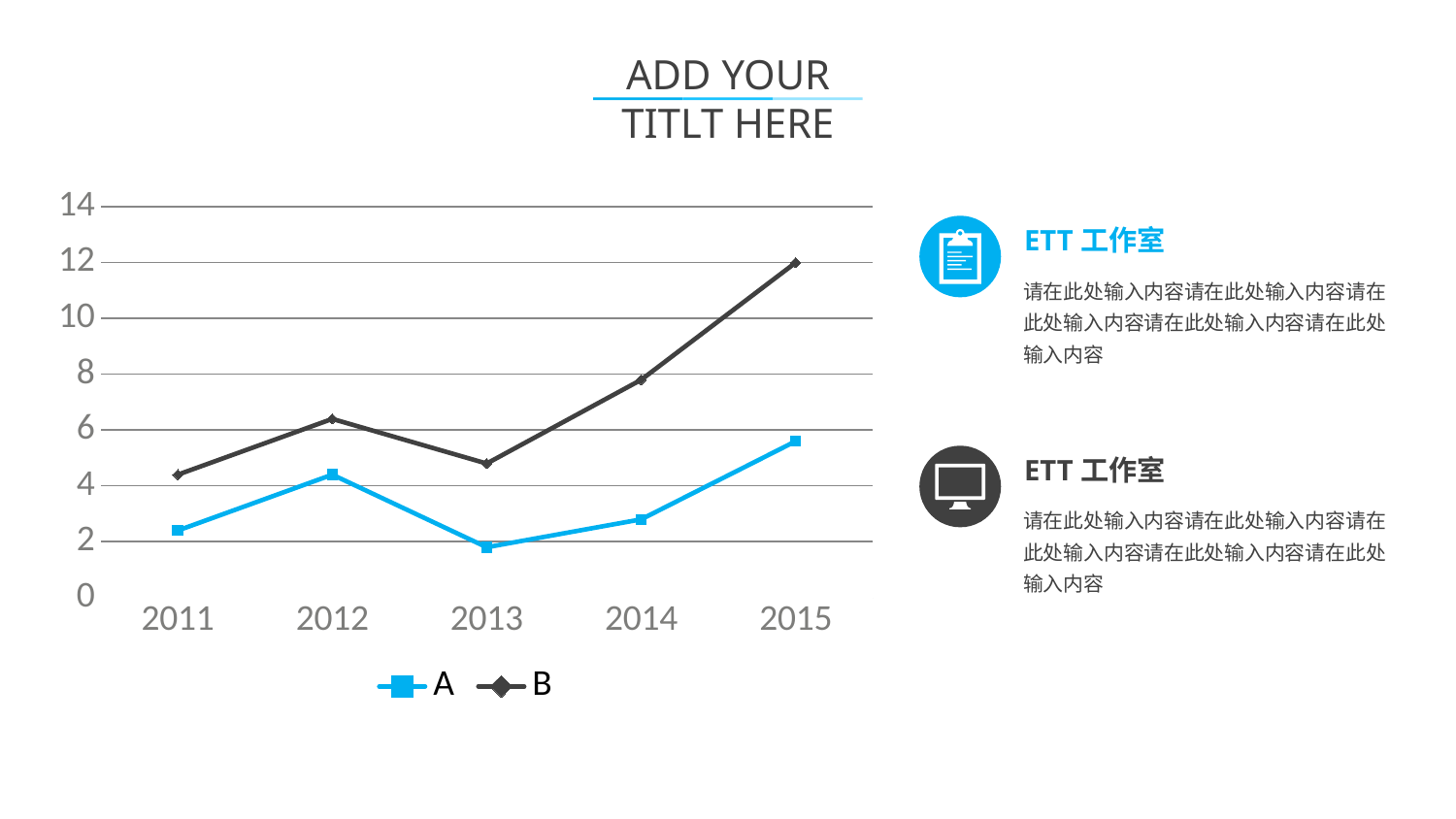
In which year does series B reach its highest value? 2015 What is the value of series B in 2015? 12 Is the value for series B in 2012 greater or less than 6? greater Which series has the larger value in 2014, A or B? B In which year does series A reach its lowest value? 2013 Does series B rise or fall between 2013 and 2015? rise Is the value for series A in 2013 greater or less than 2? less What kind of chart is shown on the slide? line chart How many years are shown on the x axis of the chart? 5 How many series does the chart legend list? 2 What colour is the line for series A in the chart? blue